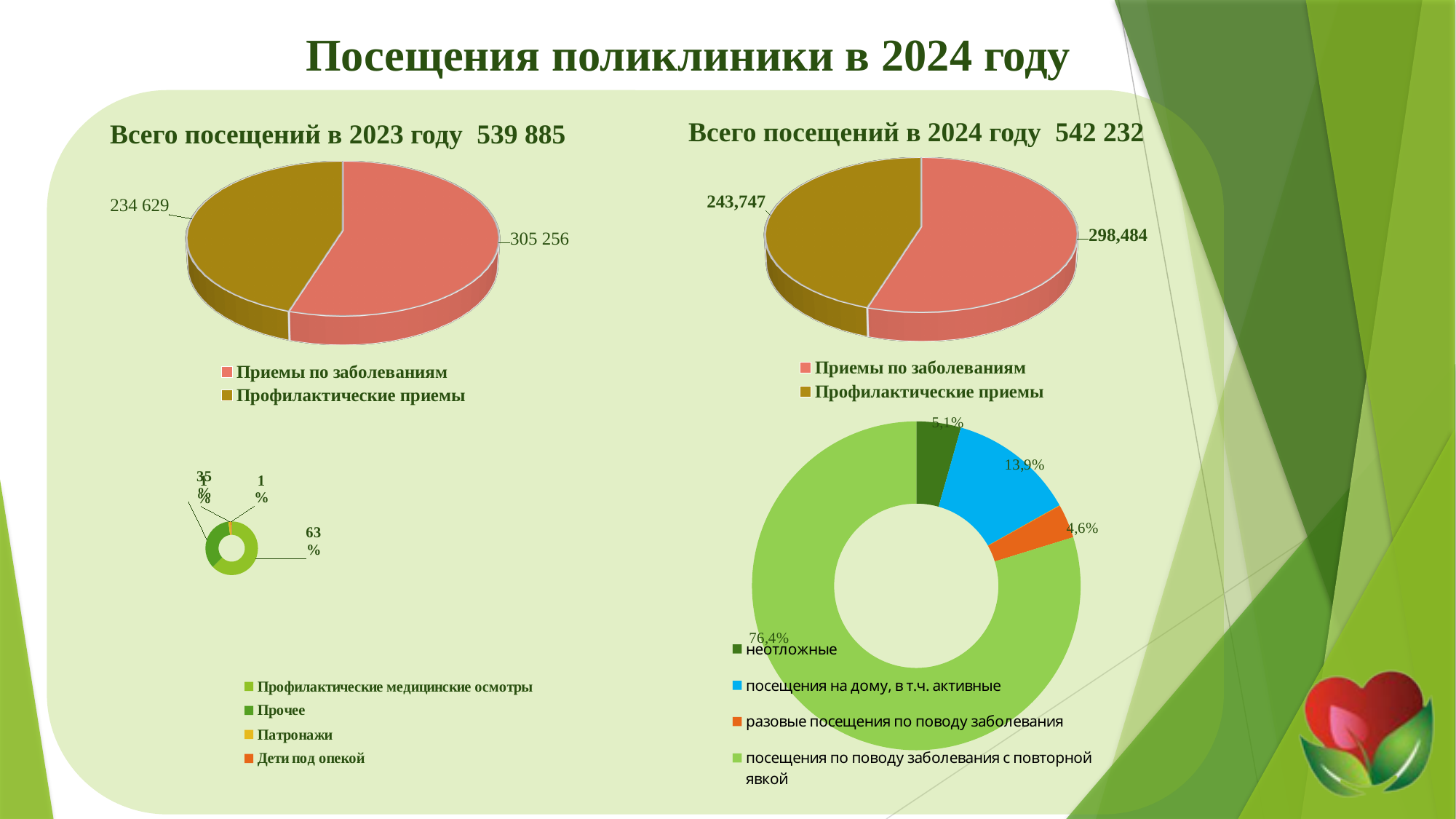
In the pie chart 'Всего посещений в 2024 году', what is the value for Приемы по заболеваниям? 298,484 In the pie chart 'Всего посещений в 2023 году', what is the value for Профилактические приемы? 234 629 In the donut chart at the bottom right, which category has the smallest share? разовые посещения по поводу заболевания In the pie chart 'Всего посещений в 2024 году', which category has the larger value? Приемы по заболеваниям Comparing the two pie charts, is the value for Профилактические приемы larger in 2023 or in 2024? 2024 In the pie chart 'Всего посещений в 2023 году', what is the value for Приемы по заболеваниям? 305 256 How many categories does the legend of the donut chart at the bottom right list? 4 In the pie chart 'Всего посещений в 2024 году', what is the difference between Приемы по заболеваниям and Профилактические приемы? 54,737 In the donut chart at the bottom right, which category has the largest share? посещения по поводу заболевания с повторной явкой In the pie chart 'Всего посещений в 2023 году', what is the difference between Приемы по заболеваниям and Профилактические приемы? 70 627 In the donut chart at the bottom right, what share is shown for 'посещения на дому, в т.ч. активные'? 13,9% In the pie chart 'Всего посещений в 2024 году', what is the value for Профилактические приемы? 243,747